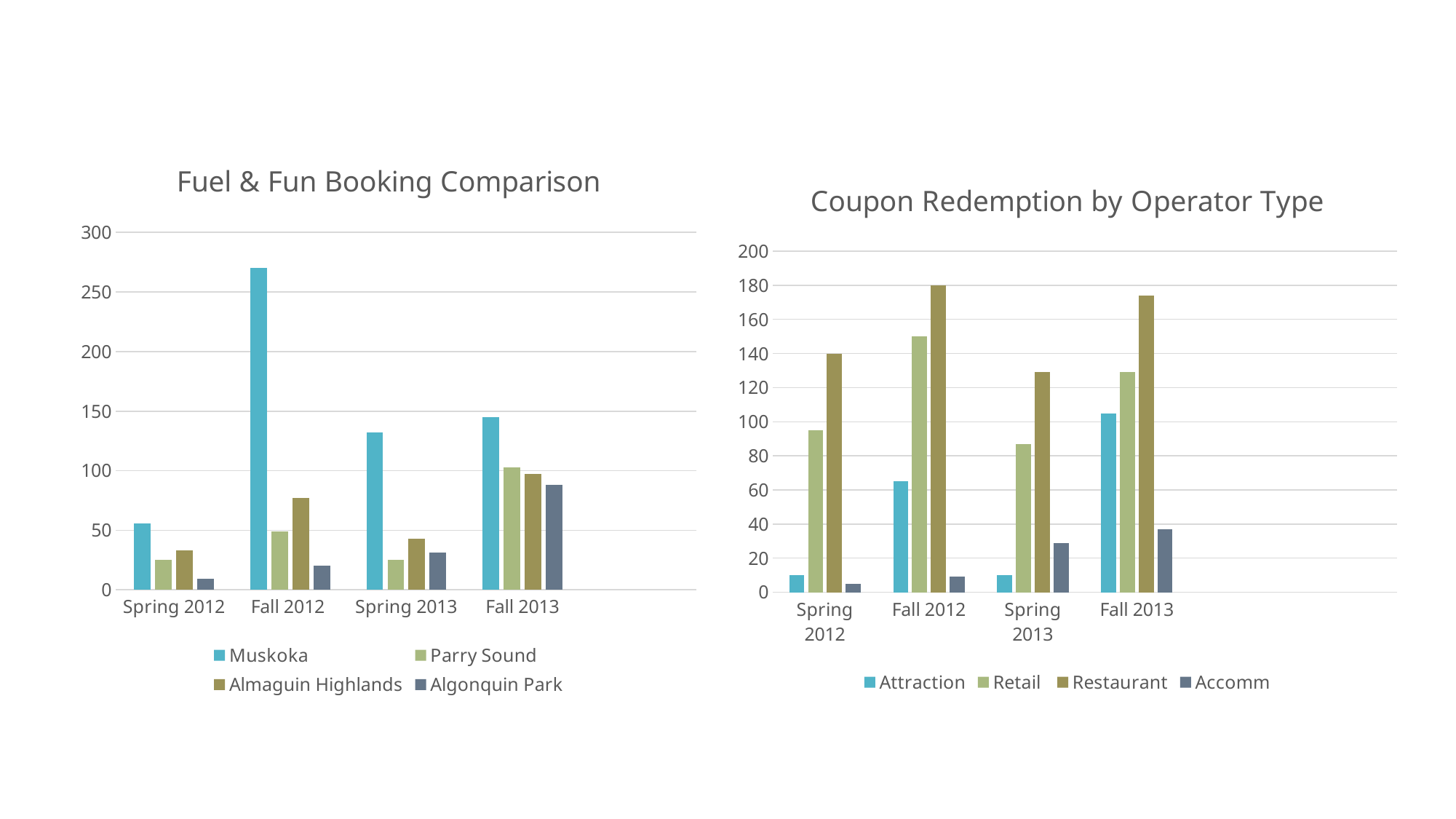
What kind of chart is the 'Fuel & Fun Booking Comparison' chart? bar chart In the 'Fuel & Fun Booking Comparison' chart, is the Muskoka value for Fall 2012 greater or less than 250? greater How many categories are shown on the x axis of the 'Fuel & Fun Booking Comparison' chart? 4 In the 'Coupon Redemption by Operator Type' chart, which is larger for Spring 2012: Retail or Restaurant? Restaurant In the 'Fuel & Fun Booking Comparison' chart, which period has the highest Muskoka value? Fall 2012 In the 'Fuel & Fun Booking Comparison' chart, which period has the lowest Algonquin Park value? Spring 2012 In the 'Fuel & Fun Booking Comparison' chart, which is larger for Spring 2013: Parry Sound or Almaguin Highlands? Almaguin Highlands In the 'Coupon Redemption by Operator Type' chart, is the Retail value for Spring 2013 greater or less than 100? less In the 'Coupon Redemption by Operator Type' chart, what is the Restaurant value for Fall 2012? 180 How many series does the legend of the 'Coupon Redemption by Operator Type' chart list? 4 In the 'Coupon Redemption by Operator Type' chart, which period has the highest Attraction value? Fall 2013